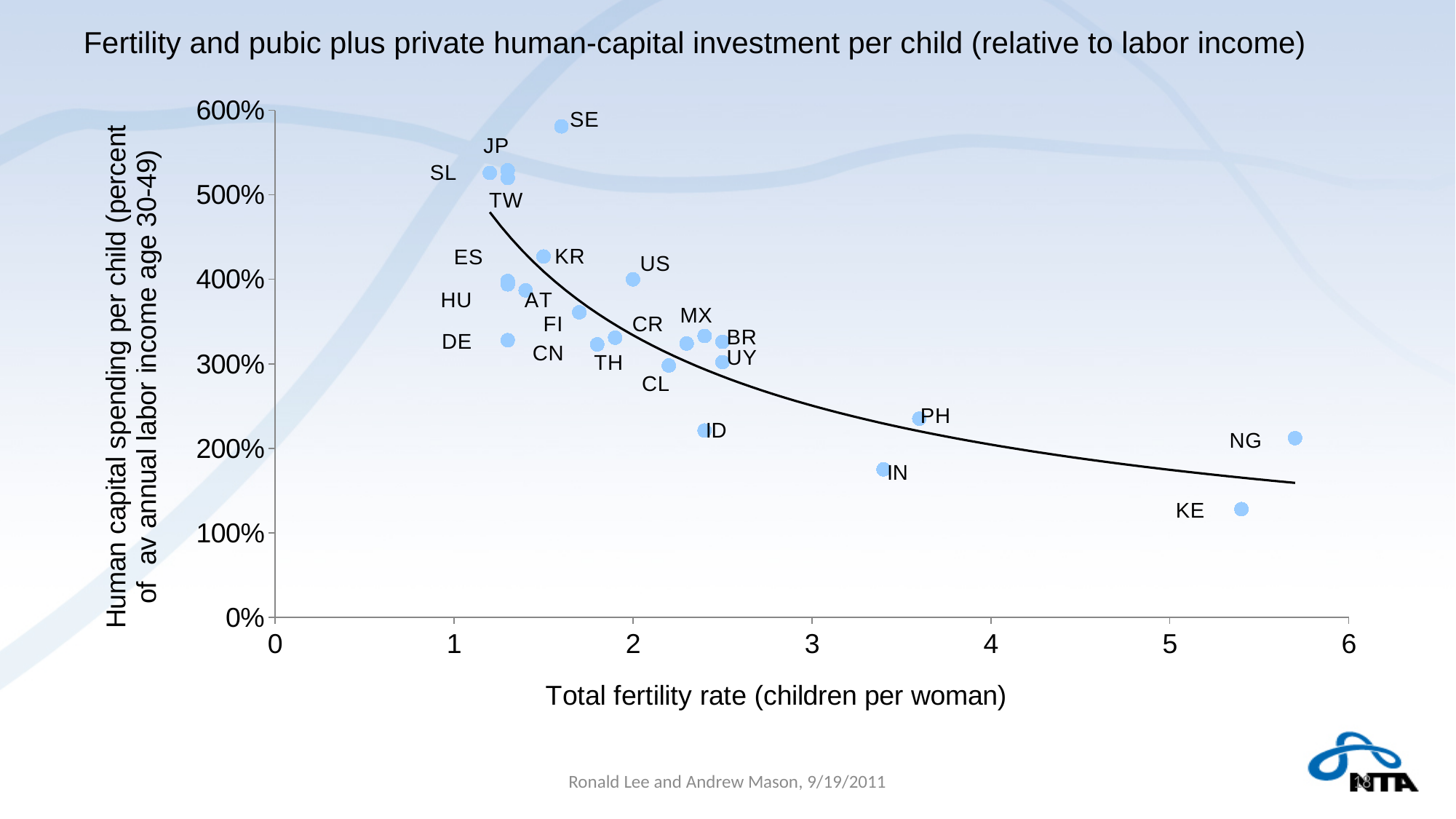
Is the total fertility rate for NG greater or less than 5? greater Which has higher human capital spending per child, US or ID? US Which has higher human capital spending per child, PH or IN? PH Is the human capital spending per child for KR greater or less than 400%? greater Which country has the lowest human capital spending per child? KE Which country has the highest total fertility rate? NG What kind of chart is shown on the slide? Scatter chart Is the human capital spending per child for SE greater or less than 500%? greater As total fertility rate increases, does human capital spending per child generally rise or fall? fall What is the title of the x axis? Total fertility rate (children per woman) Which country has the highest human capital spending per child? SE